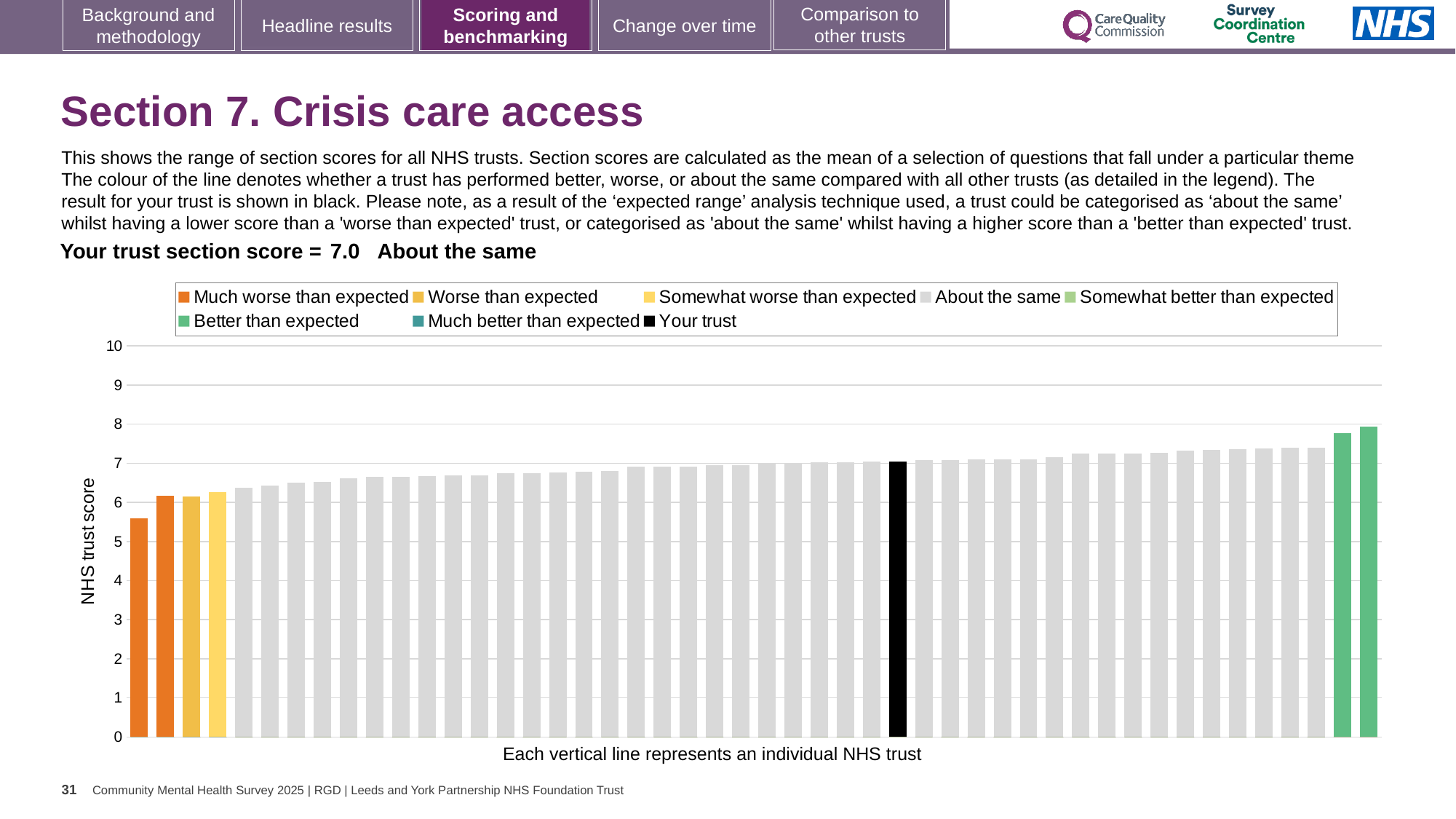
Is the value for the highest (rightmost) bar greater or less than 7? greater Which is larger: the value for the black 'Your trust' bar or the value for the leftmost orange bar? Your trust Is the value for the lowest (leftmost) bar greater or less than 6? less What is the section score for your trust shown on the slide? 7.0 How many entries does the chart legend list? 8 What kind of chart is shown on the slide? bar chart Do the bar values rise or fall from left to right along the x axis? rise What is the label on the vertical axis of the chart? NHS trust score How many bars are coloured green (Better than expected)? 2 What colour is the bar representing your trust? black Is the value for the black 'Your trust' bar greater or less than 6? greater